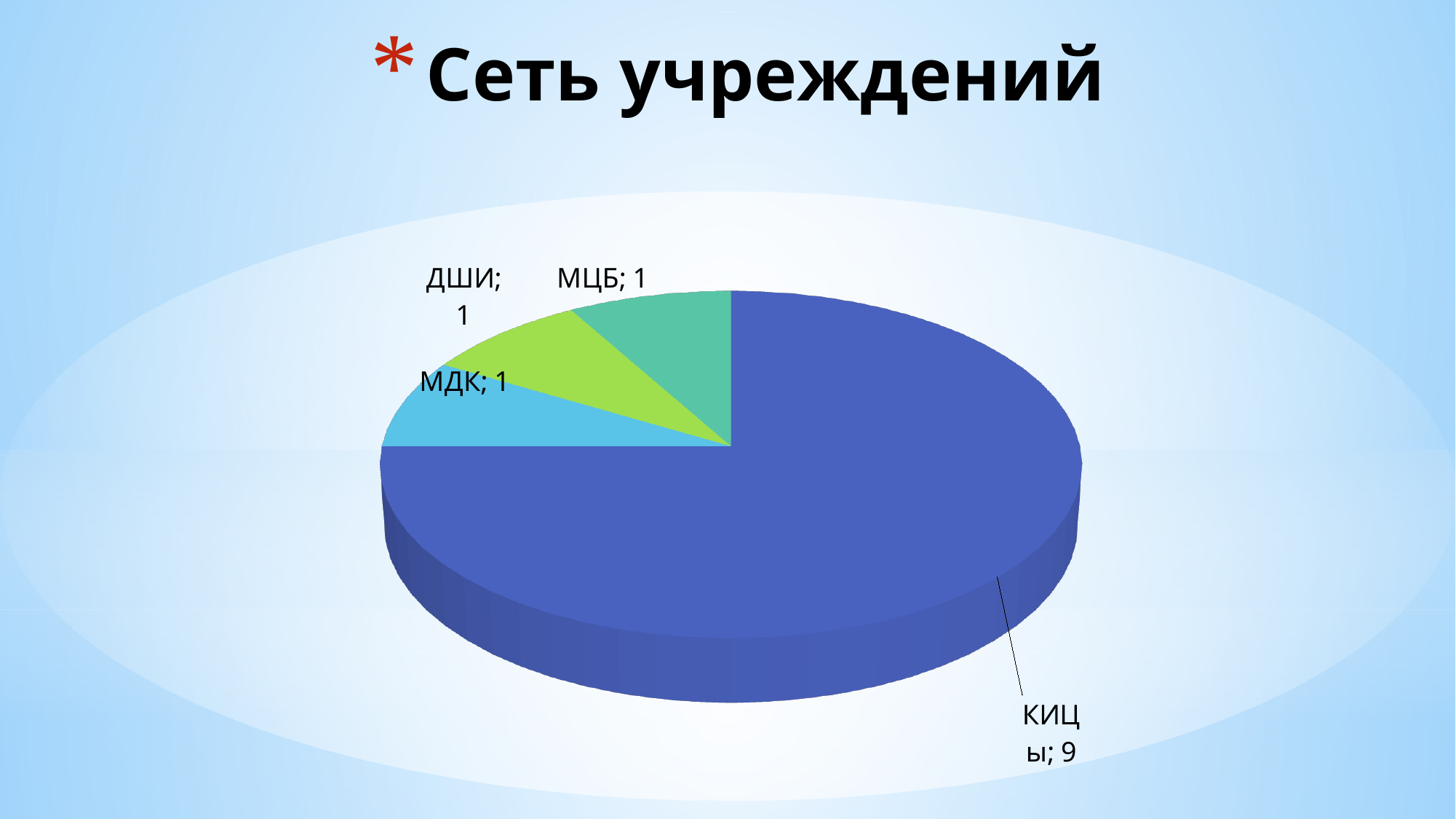
What is the value for МЦБ in the pie chart? 1 What kind of chart is shown on the slide? pie chart What is the difference between the values for КИЦы and МДК? 8 What share of the pie does КИЦы represent? 75% What is the title of the chart on the slide? Сеть учреждений What is the total of all slices in the pie chart? 12 How many slices does the pie chart have? 4 What is the value for КИЦы in the pie chart? 9 Which category has the largest slice in the pie chart? КИЦы What is the value for ДШИ in the pie chart? 1 What is the value for МДК in the pie chart? 1 Which is larger, the value for КИЦы or the value for МЦБ? КИЦы